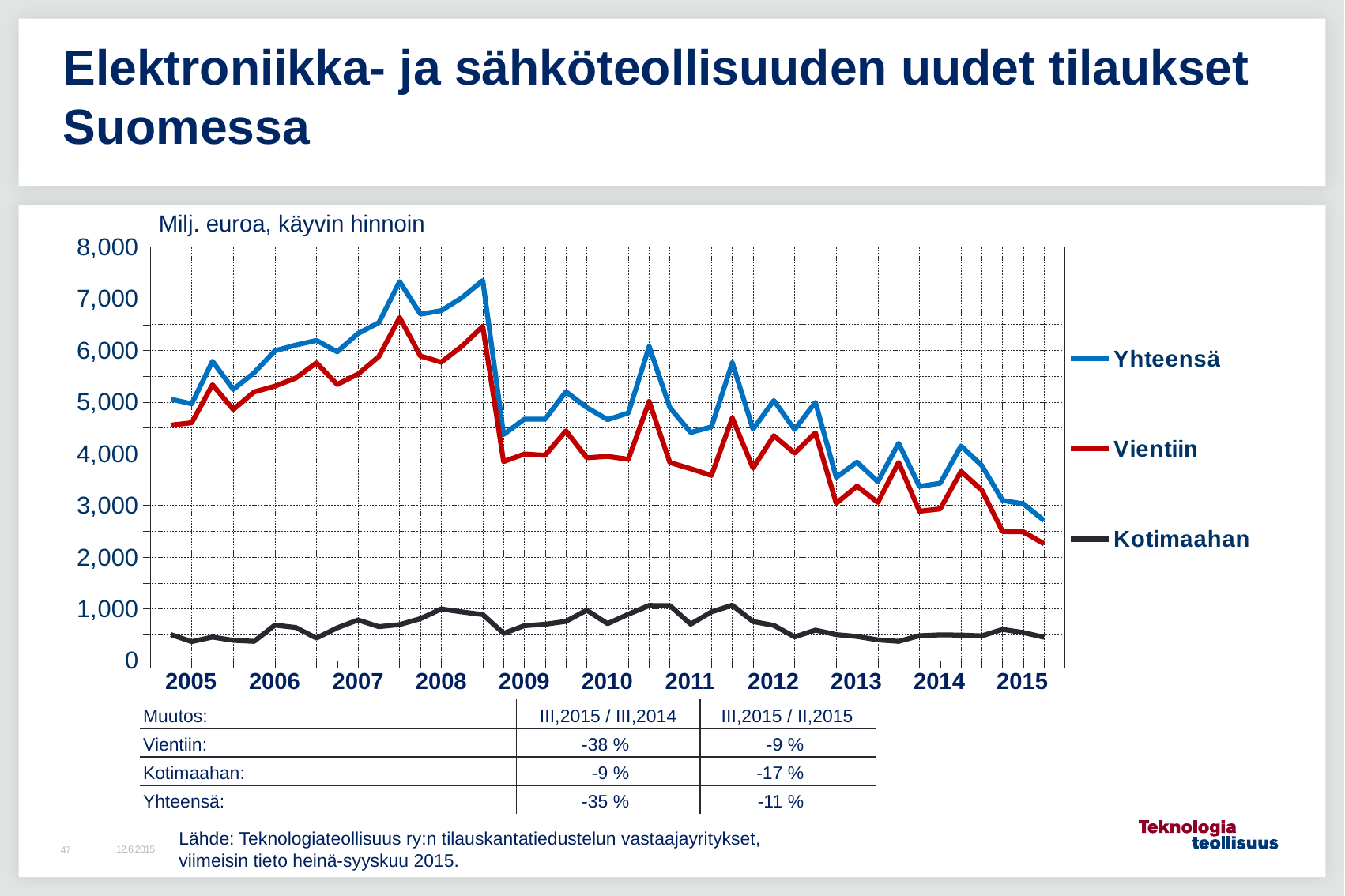
What are the three series named in the chart's legend? Yhteensä, Vientiin, Kotimaahan Which series has higher values throughout the chart, Yhteensä or Kotimaahan? Yhteensä Is the highest value of the Yhteensä line, reached in 2008, greater or less than 7,000? greater Which series is lower throughout the chart, Vientiin or Kotimaahan? Kotimaahan What unit label is shown above the chart's y axis? Milj. euroa, käyvin hinnoin Is the last plotted value of the Vientiin line in 2015 greater or less than 3,000? less Is the value of the Kotimaahan line at any point greater or less than 2,000? less Does the Yhteensä line generally rise or fall from 2012 to 2015? fall How many series does the chart's legend list? 3 How many years are labelled on the chart's x axis? 11 What kind of chart is shown on the slide? line chart